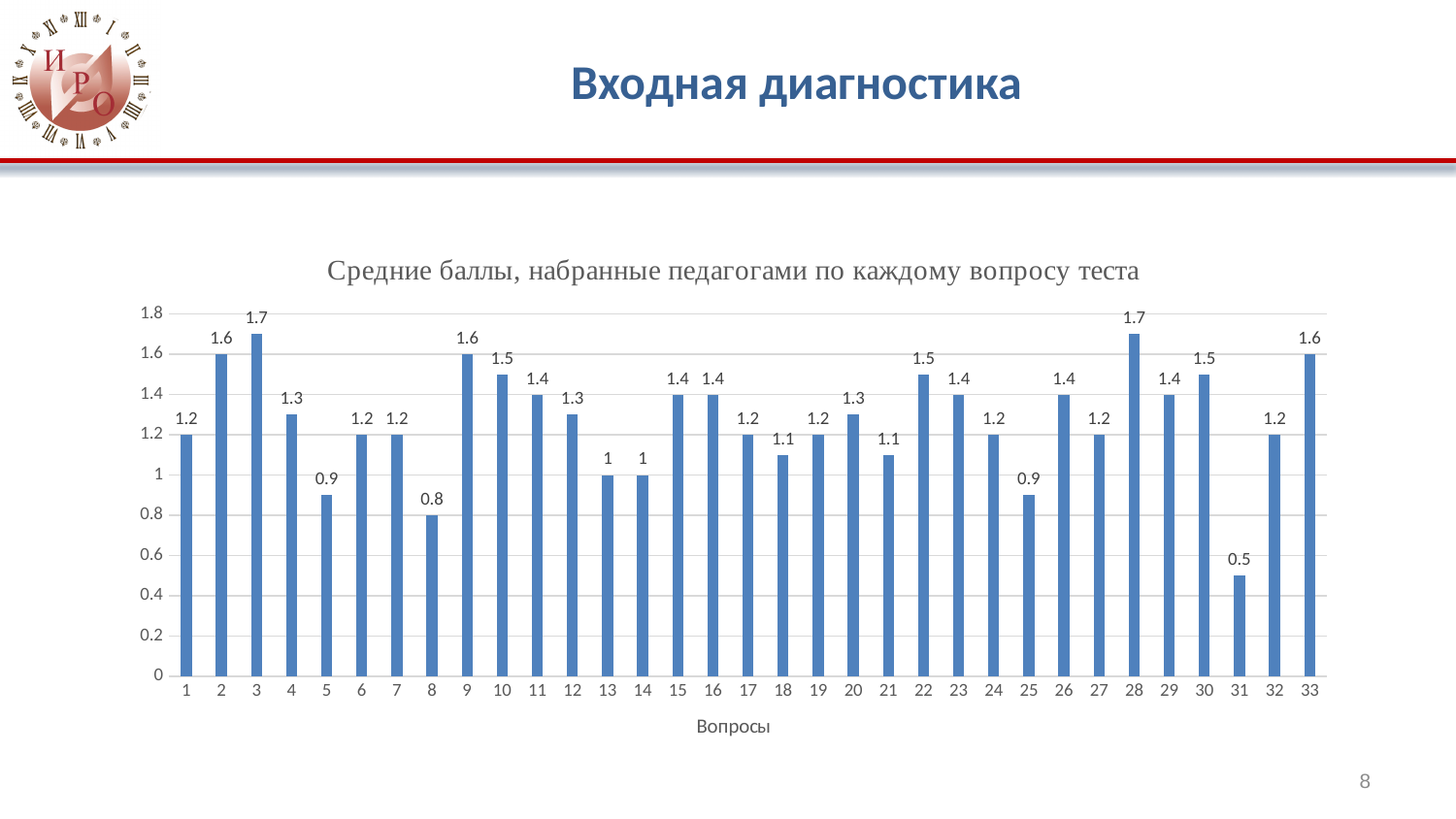
What is the label of the x axis? Вопросы What is the difference between the average scores for question 28 and question 31? 1.2 What is the highest average score shown on the chart? 1.7 What is the average score for question 22? 1.5 Which has a higher average score, question 9 or question 5? question 9 What is the average score for question 3? 1.7 Which question has the lowest average score? 31 What is the average score for question 8? 0.8 What is the average score for question 31? 0.5 What type of chart is shown on the slide? bar chart What is the title of the chart? Средние баллы, набранные педагогами по каждому вопросу теста How many questions are shown on the x axis? 33